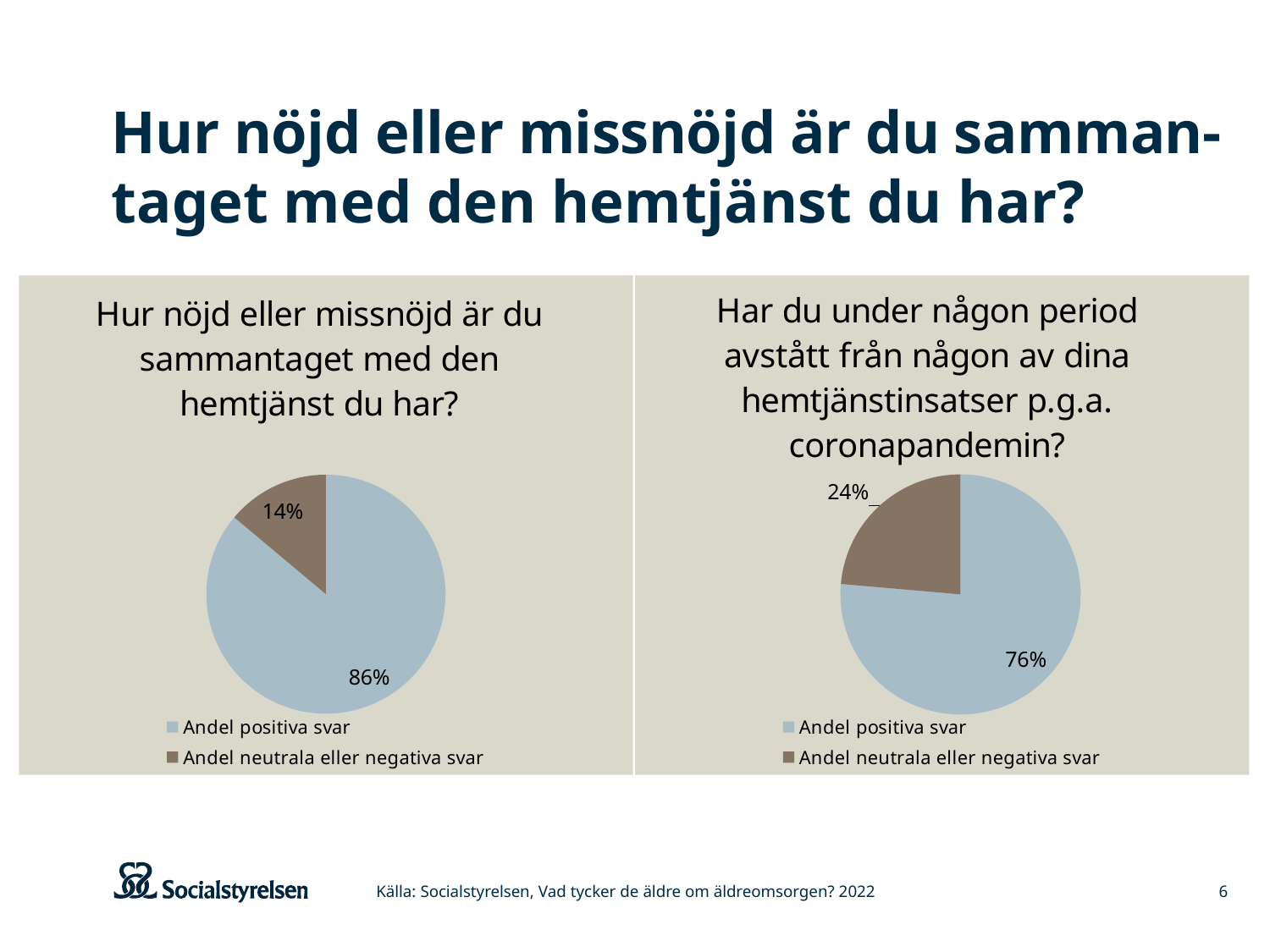
In the right pie chart, what share is labelled for "Andel neutrala eller negativa svar"? 24% Which chart has the larger share of "Andel neutrala eller negativa svar", the left pie chart or the right pie chart? The right pie chart What is the title of the right pie chart? Har du under någon period avstått från någon av dina hemtjänstinsatser p.g.a. coronapandemin? In the left pie chart, what is the difference in percentage points between "Andel positiva svar" and "Andel neutrala eller negativa svar"? 72 percentage points In the left pie chart, which slice is the largest? Andel positiva svar In the right pie chart ("Har du under någon period avstått från någon av dina hemtjänstinsatser p.g.a. coronapandemin?"), what share is labelled for "Andel positiva svar"? 76% In the right pie chart, which slice is the smallest? Andel neutrala eller negativa svar How many entries does the legend of the left pie chart list? 2 How many slices does the right pie chart have? 2 In the left pie chart ("Hur nöjd eller missnöjd är du sammantaget med den hemtjänst du har?"), what share is labelled for "Andel positiva svar"? 86% In the left pie chart, what share is labelled for "Andel neutrala eller negativa svar"? 14% What type of chart is used on the left side of the slide? Pie chart